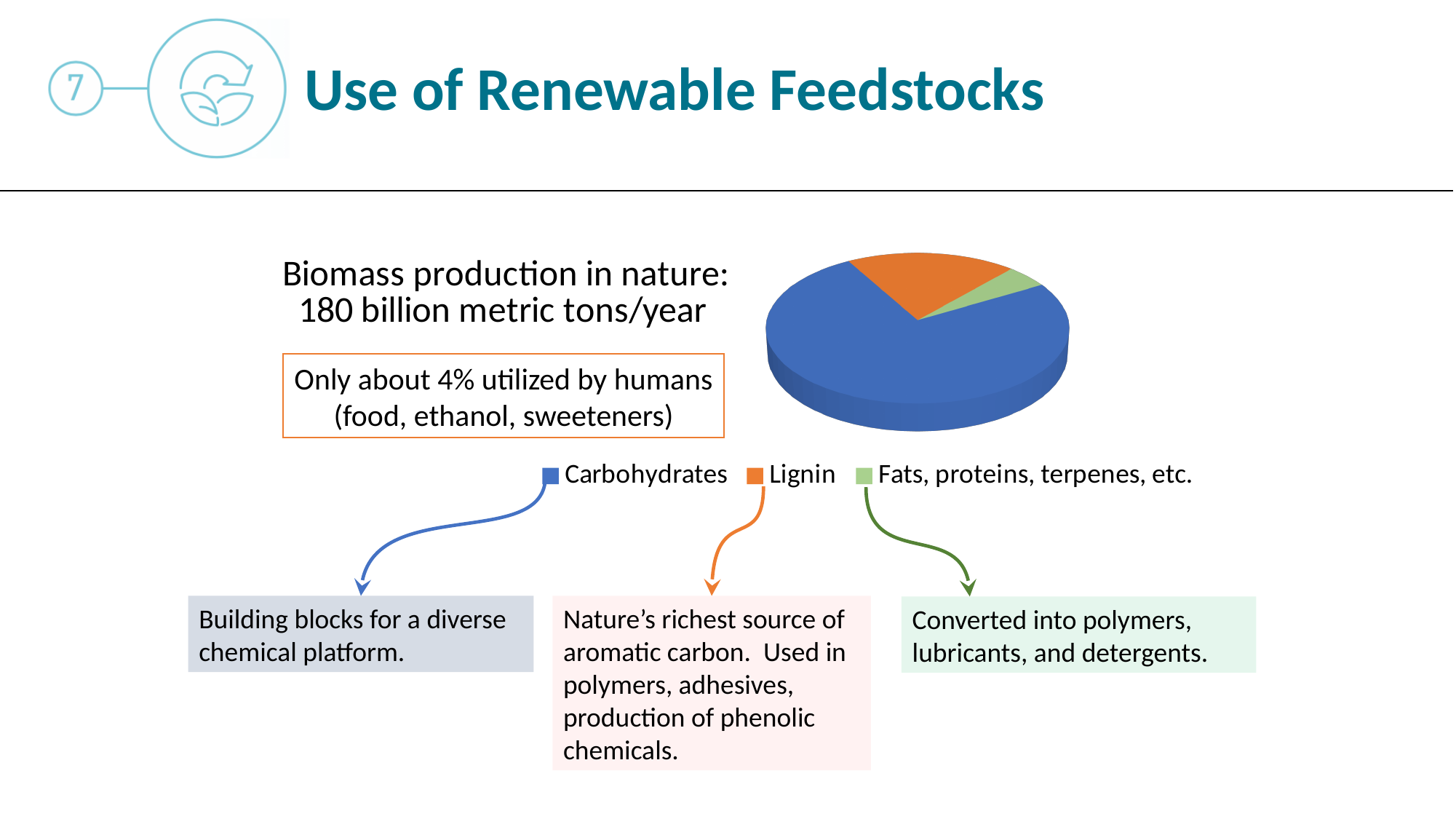
Does the Carbohydrates slice make up more or less than half of the pie chart? more Which category has the smallest slice of the pie chart? Fats, proteins, terpenes, etc. Which slice is larger in the pie chart, Carbohydrates or Lignin? Carbohydrates How many entries does the pie chart's legend list? 3 How many slices does the pie chart have? 3 Which category has the largest slice of the pie chart? Carbohydrates What kind of chart is shown on the slide? pie chart What colour is the Lignin slice in the pie chart? orange Which category is shown in green in the pie chart? Fats, proteins, terpenes, etc. Which slice is larger in the pie chart, Lignin or Fats, proteins, terpenes, etc.? Lignin